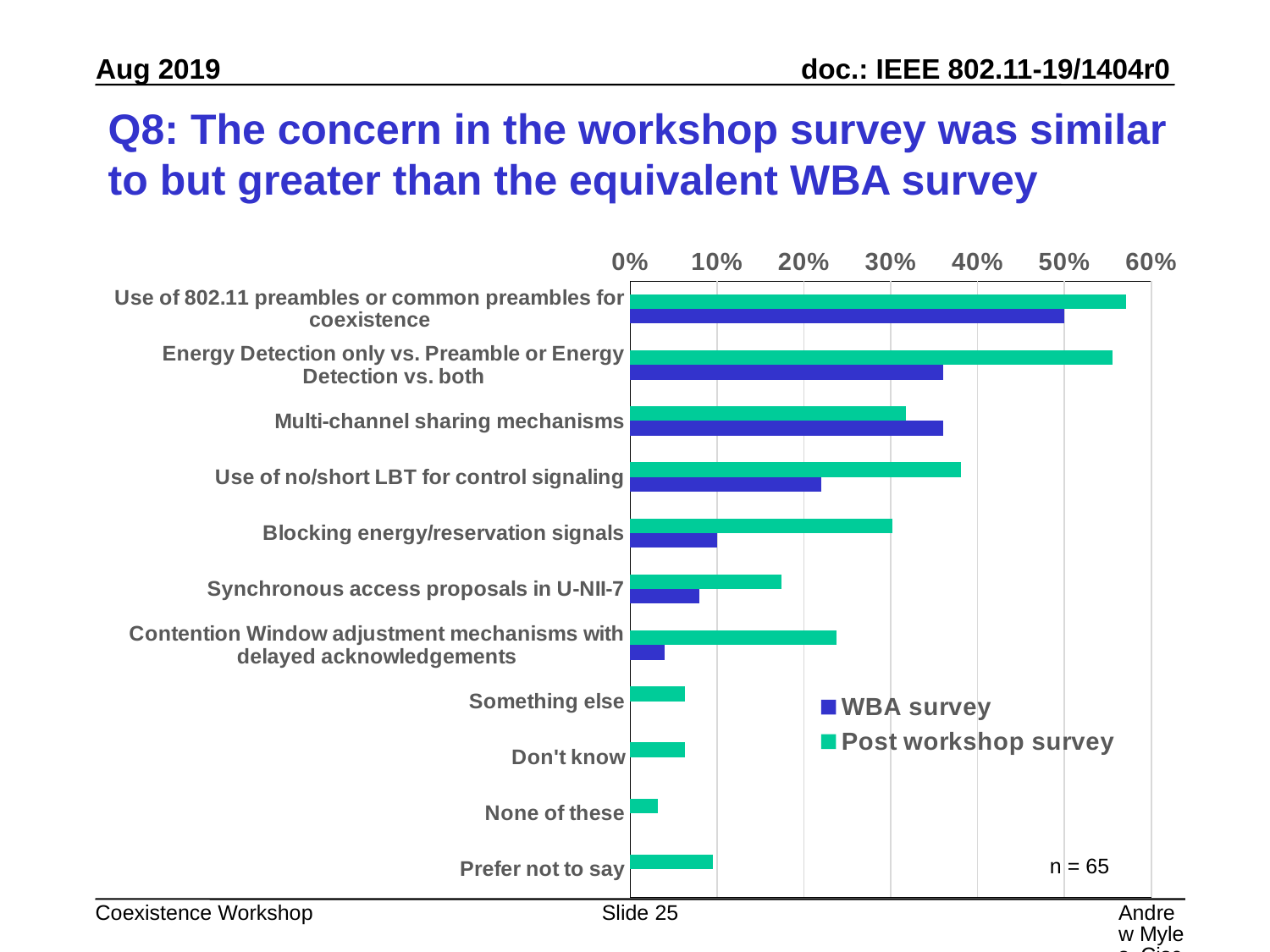
For 'Multi-channel sharing mechanisms', which series has the larger value, WBA survey or Post workshop survey? WBA survey How many categories are shown on the chart? 11 What are the two series named in the legend? WBA survey and Post workshop survey Is the Post workshop survey value for 'Energy Detection only vs. Preamble or Energy Detection vs. both' greater or less than 50%? greater For 'Use of no/short LBT for control signaling', which series has the larger value, WBA survey or Post workshop survey? Post workshop survey What kind of chart is shown on the slide? bar chart Is the WBA survey value for 'Blocking energy/reservation signals' greater or less than 20%? less Is the WBA survey value for 'Synchronous access proposals in U-NII-7' greater or less than 10%? less Which category has the lowest value for the Post workshop survey series? None of these Which category has the highest value for the WBA survey series? Use of 802.11 preambles or common preambles for coexistence How many series does the legend list? 2